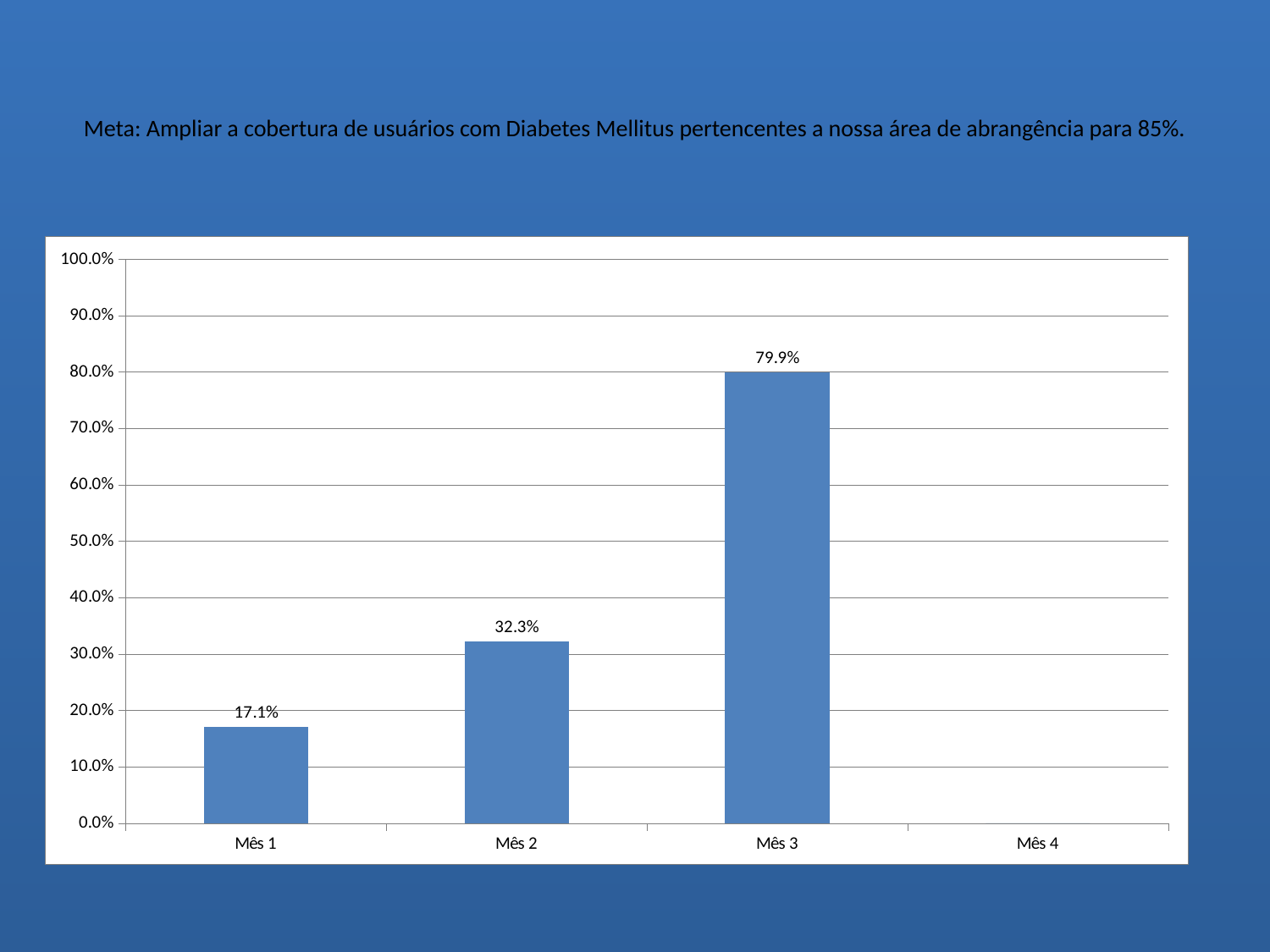
Do the values rise or fall from Mês 1 to Mês 3? Rise How many categories are shown on the x axis? 4 What is the difference between the values for Mês 2 and Mês 1? 15.2% Among the months with a visible bar, which has the lowest value? Mês 1 Is the value for Mês 3 greater or less than 70.0%? greater What is the value for Mês 2? 32.3% Which is larger, the value for Mês 2 or the value for Mês 1? Mês 2 What is the difference between the values for Mês 3 and Mês 2? 47.6% What kind of chart is shown on the slide? Bar chart Which month has the highest value? Mês 3 What is the value for Mês 3? 79.9% What is the value for Mês 1? 17.1%